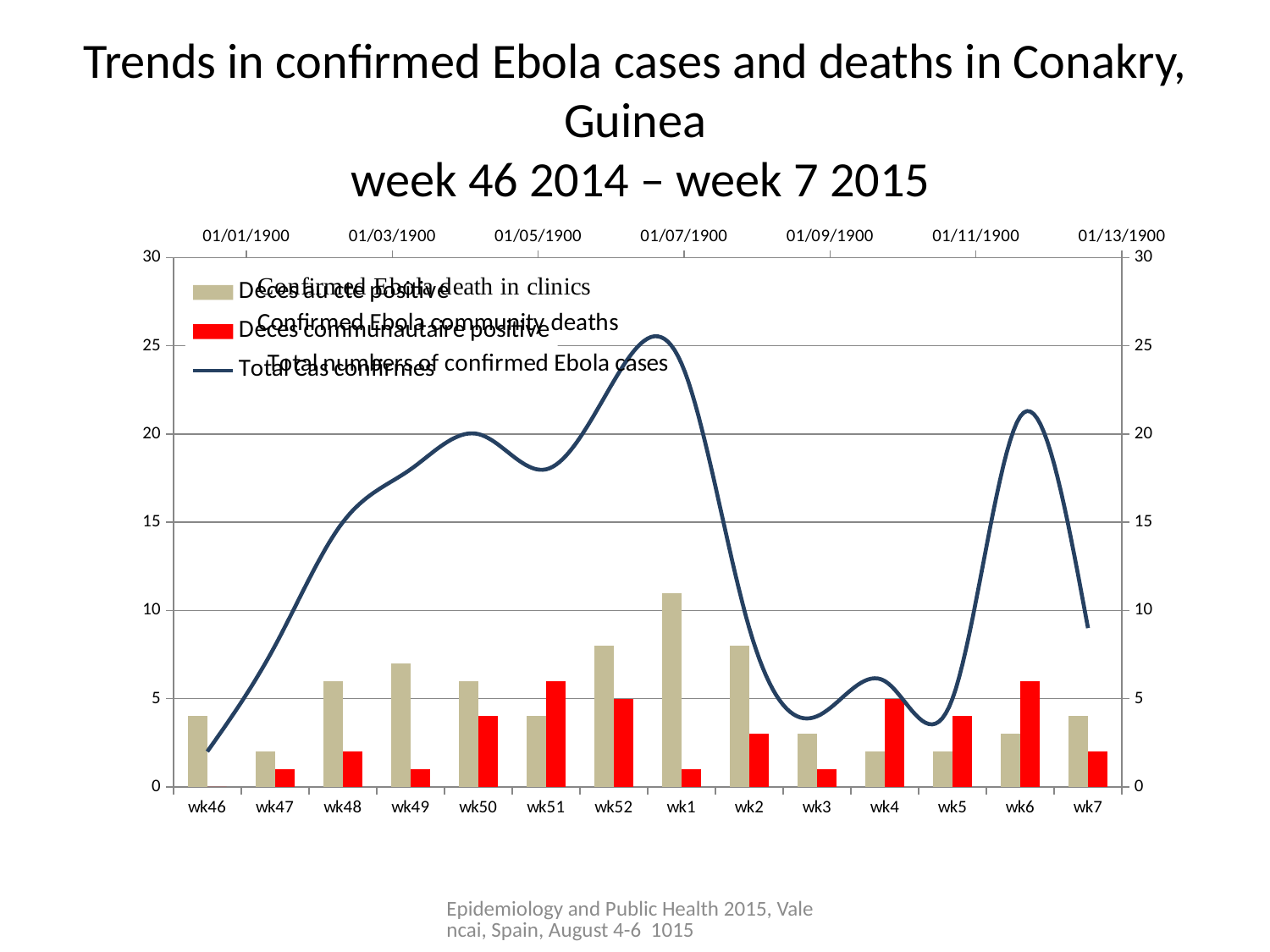
Is the total number of confirmed Ebola cases in wk6 greater or less than 20? greater Does the line for total confirmed Ebola cases rise or fall from wk46 to wk1? rise Is the total number of confirmed Ebola cases in wk3 greater or less than 5? less Is the value for confirmed Ebola deaths in clinics in wk52 greater or less than 10? less How many weeks are shown along the x axis? 14 Which week has the highest bar for confirmed Ebola deaths in clinics? wk1 Which colour represents confirmed Ebola community deaths? Red Which is larger: confirmed Ebola deaths in clinics in wk1 or in wk2? wk1 What kind of chart is shown on the slide? Combination bar and line chart How many series does the legend list? 3 In which week does the line for total numbers of confirmed Ebola cases reach its highest point? wk1